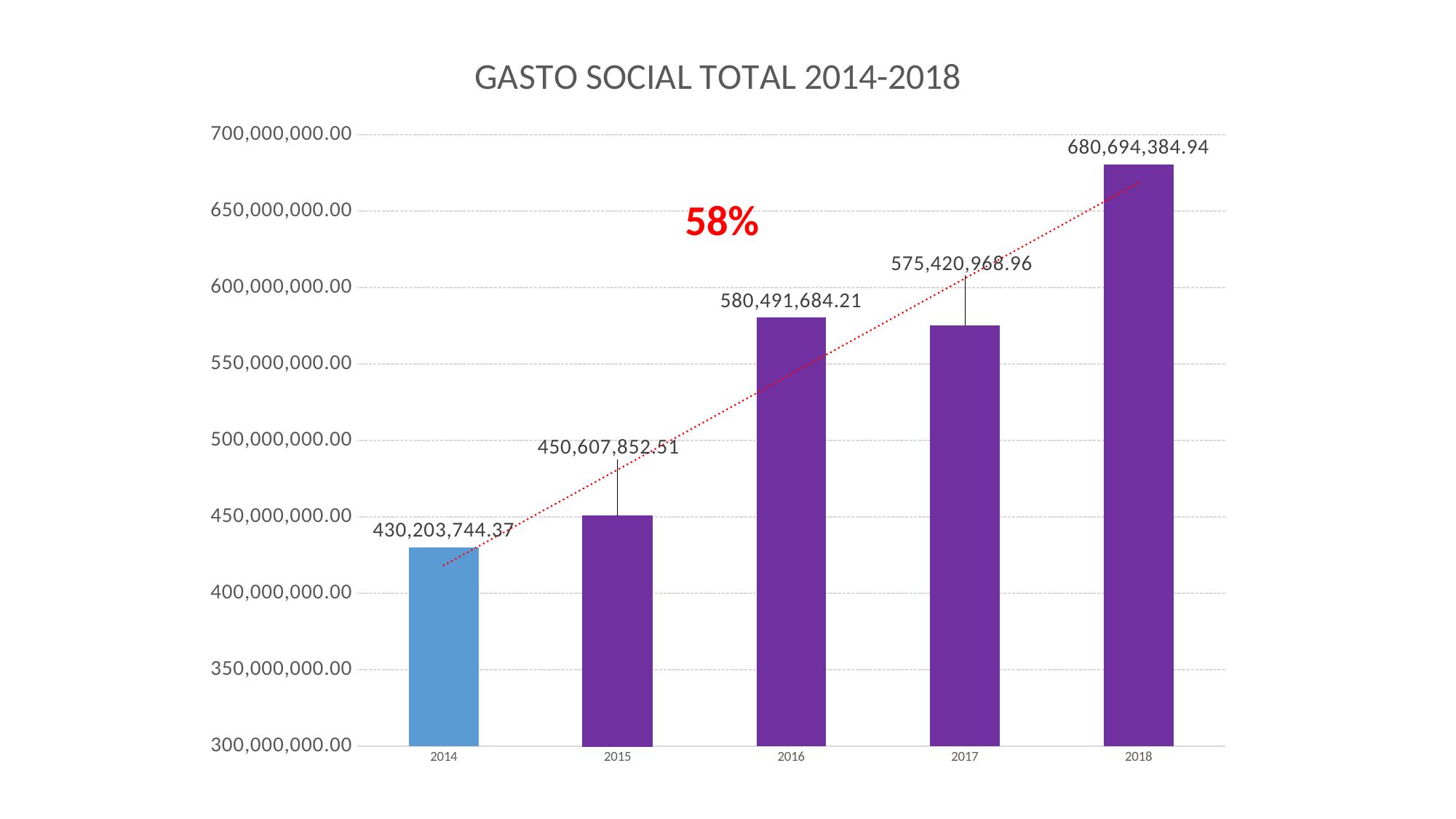
Which year has the lowest value? 2014 Is the value for 2018 greater or less than 650,000,000.00? greater What percentage is printed in red on the chart? 58% What is the difference between the values for 2018 and 2014? 250,490,640.57 What is the value for 2014? 430,203,744.37 Which year has the highest value? 2018 What is the difference between the values for 2016 and 2017? 5,070,715.25 What is the value for 2018? 680,694,384.94 How many years are shown on the x axis? 5 Which is larger, the value for 2016 or the value for 2017? 2016 What is the value for 2017? 575,420,968.96 What kind of chart is this? bar chart